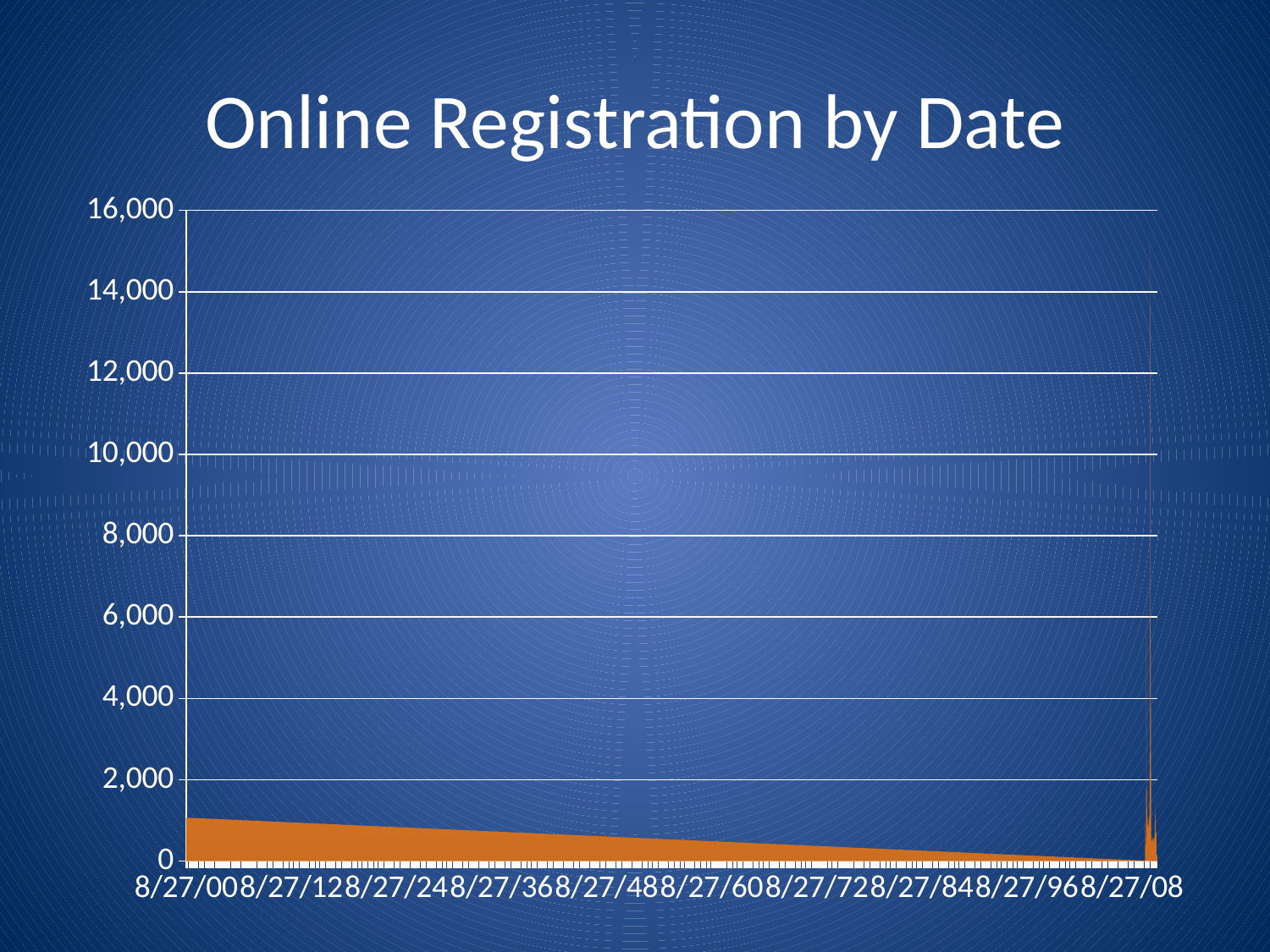
Is the value at the midpoint of the x axis greater or less than 2,000? less How many labelled tick marks are on the y axis of the chart? 9 Is the peak value at the far right of the chart greater or less than 10,000? greater What is the highest value shown on the y axis of the chart? 16,000 Is the value at the leftmost point of the chart greater or less than 2,000? less What is the title of the chart? Online Registration by Date What kind of chart is shown on the slide? Area chart Across most of the x axis, before the spike at the far right, do the values rise or fall? fall